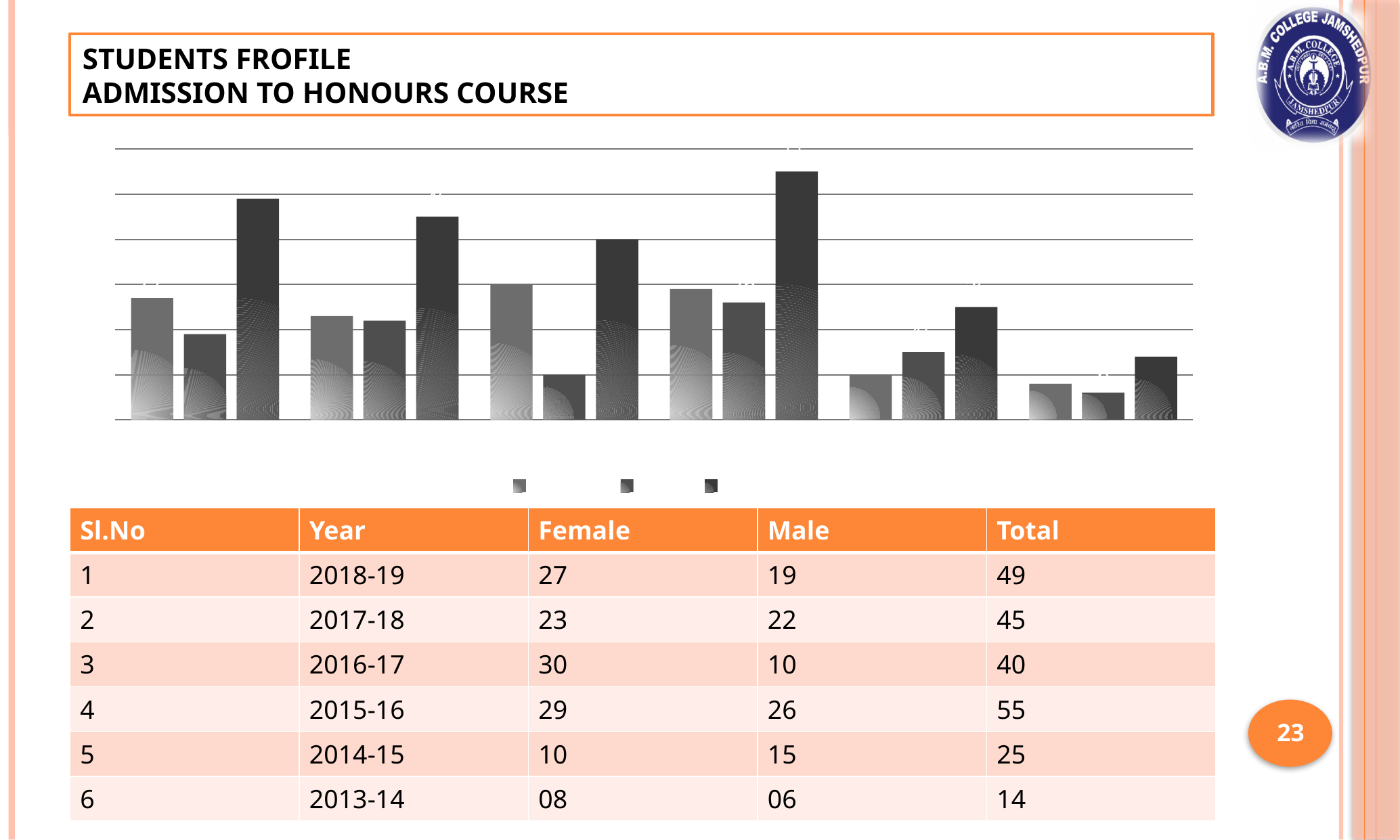
How many series does the chart's legend list? 3 Within each group, is the tallest bar the first, second or third bar? the third bar How many bars are in each group of the chart? 3 What kind of chart is shown on the slide? bar chart Counting from the left, which group of bars contains the tallest bar in the chart? the fourth group Counting from the left, which group of bars contains the shortest bar in the chart? the sixth group How many groups of bars does the chart show? 6